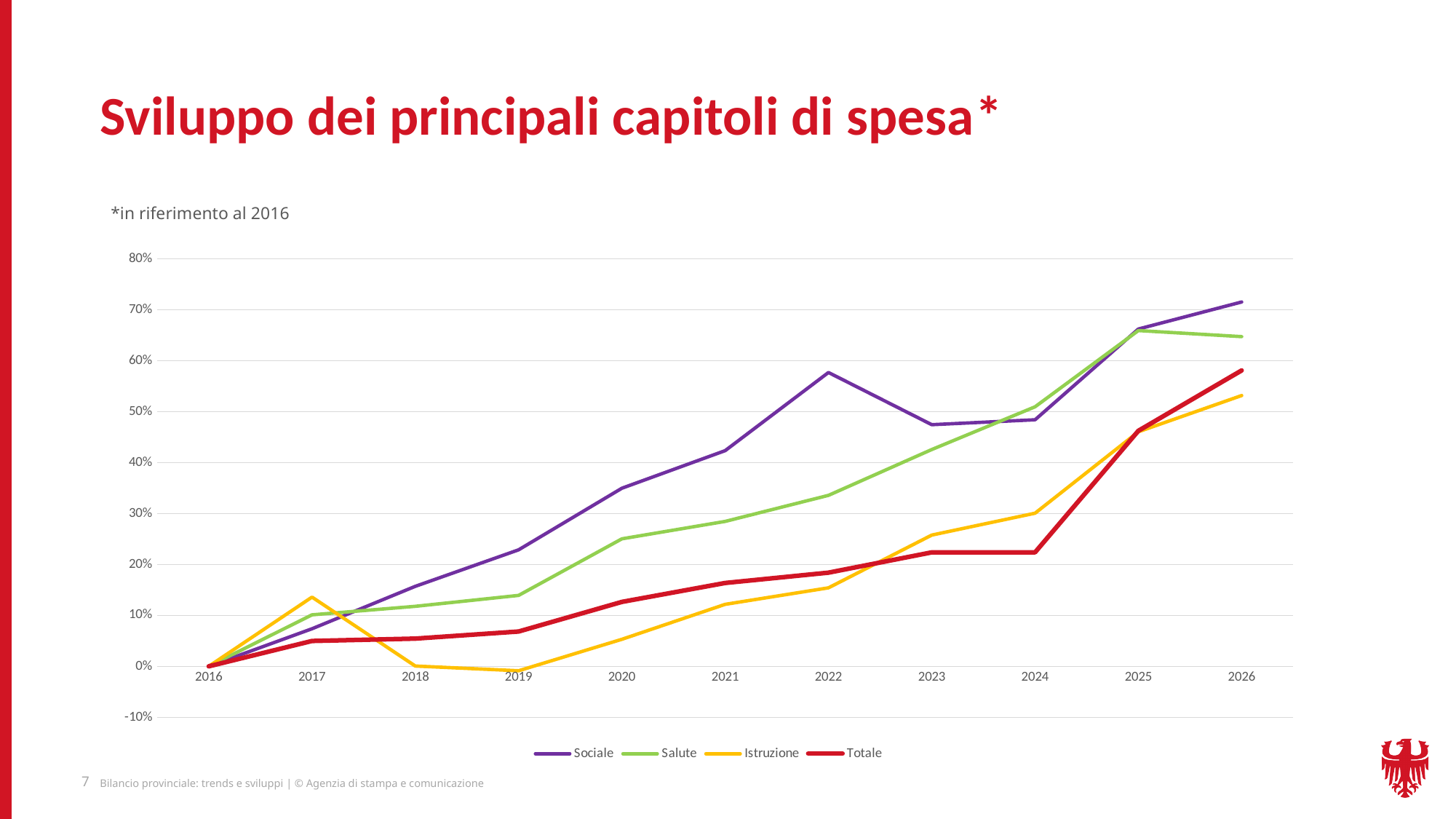
Which series has the highest value in 2026? Sociale Which series has the lowest value in 2026? Istruzione Is the value for Salute in 2026 greater or less than 60%? greater How many years are plotted along the x axis? 11 What is the value for Totale in 2016? 0% Is the value for Totale in 2024 greater or less than 30%? less How many series does the legend list? 4 Does the Totale series generally rise or fall from 2016 to 2026? rise In 2022, which is larger: Sociale or Salute? Sociale What kind of chart is shown on the slide? line chart Is the value for Sociale in 2022 greater or less than 50%? greater What is the title of the chart on the slide? Sviluppo dei principali capitoli di spesa*